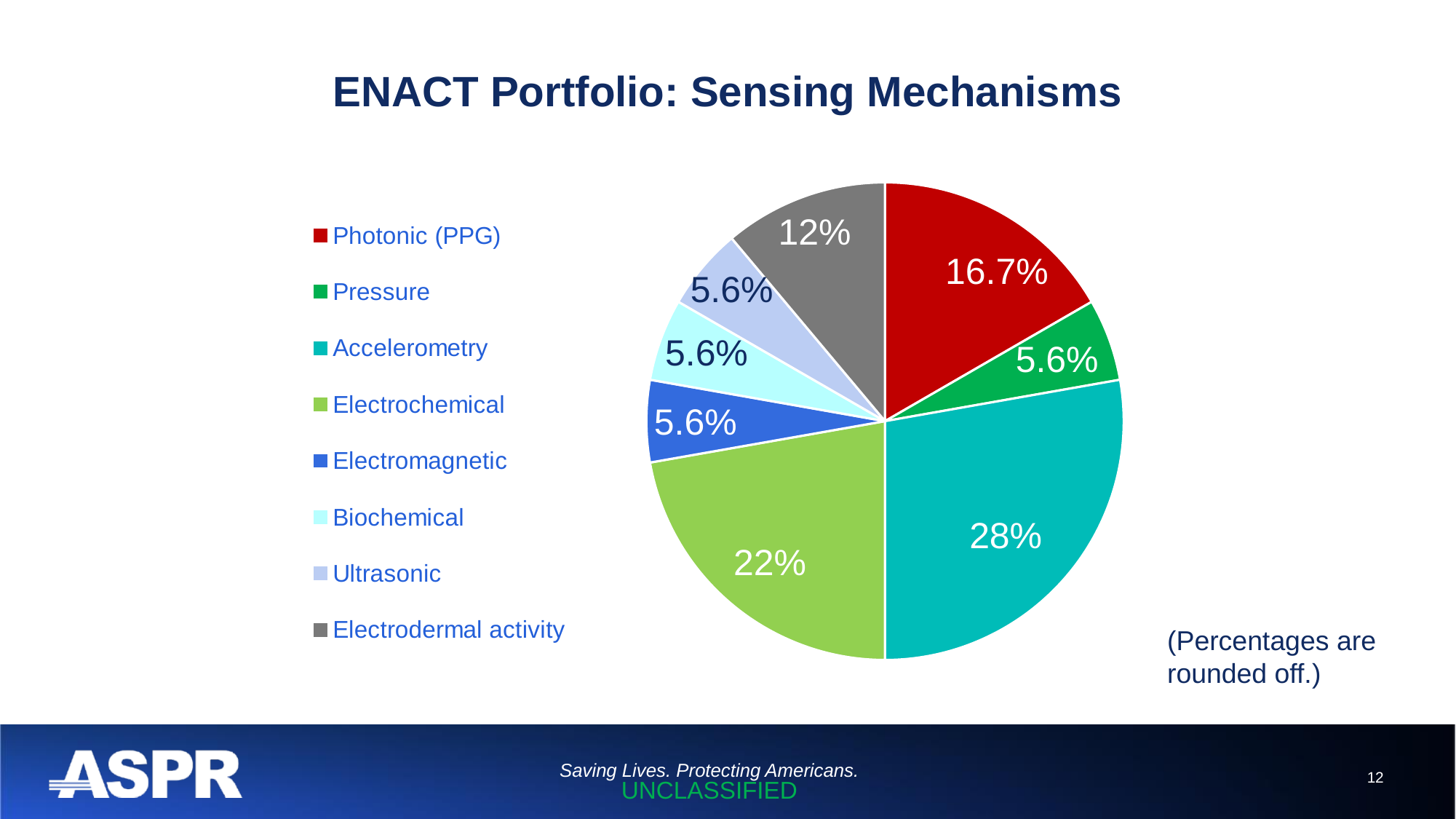
What percentage is shown for Electrodermal activity? 12% What is the difference in percentage points between Photonic (PPG) and Electrodermal activity? 4.7 What is the difference in percentage points between Accelerometry and Electrochemical? 6 What share of the pie does Accelerometry account for? 28% What percentage is shown for Ultrasonic? 5.6% Which sensing mechanism has the largest slice of the pie? Accelerometry What type of chart is shown on the slide? Pie chart Which is larger, the slice for Electrochemical or the slice for Photonic (PPG)? Electrochemical What percentage is shown for Electrochemical? 22% How many slices of the pie are labelled 5.6%? 4 What is the value shown for Photonic (PPG)? 16.7% How many sensing mechanisms are listed in the legend? 8